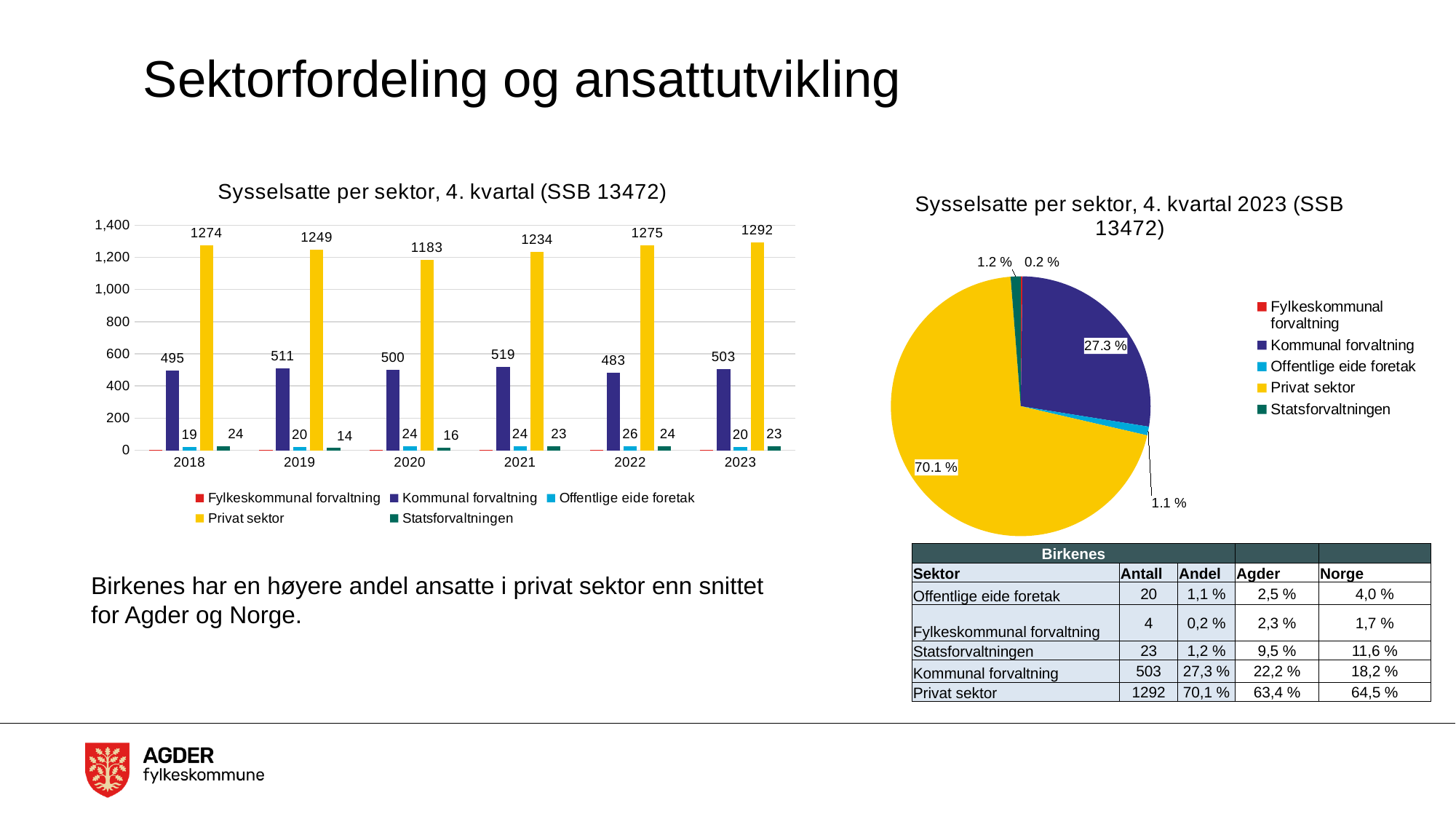
In the pie chart 'Sysselsatte per sektor, 4. kvartal 2023 (SSB 13472)', which sector has the smallest slice? Fylkeskommunal forvaltning In the bar chart 'Sysselsatte per sektor, 4. kvartal (SSB 13472)', which is larger: Statsforvaltningen in 2019 or Offentlige eide foretak in 2019? Offentlige eide foretak In the bar chart 'Sysselsatte per sektor, 4. kvartal (SSB 13472)', what is the difference between Privat sektor in 2023 and in 2022? 17 What kind of chart is the left chart 'Sysselsatte per sektor, 4. kvartal (SSB 13472)'? Bar chart In the bar chart 'Sysselsatte per sektor, 4. kvartal (SSB 13472)', in which year is Privat sektor highest? 2023 In the bar chart 'Sysselsatte per sektor, 4. kvartal (SSB 13472)', what is the value for Privat sektor in 2023? 1292 In the bar chart 'Sysselsatte per sektor, 4. kvartal (SSB 13472)', what is the value for Kommunal forvaltning in 2021? 519 In the pie chart 'Sysselsatte per sektor, 4. kvartal 2023 (SSB 13472)', what share does Kommunal forvaltning have? 27.3 % In the bar chart 'Sysselsatte per sektor, 4. kvartal (SSB 13472)', how many series does the legend list? 5 In the bar chart 'Sysselsatte per sektor, 4. kvartal (SSB 13472)', in which year is Privat sektor lowest? 2020 In the pie chart 'Sysselsatte per sektor, 4. kvartal 2023 (SSB 13472)', what share does Privat sektor have? 70.1 % In the bar chart 'Sysselsatte per sektor, 4. kvartal (SSB 13472)', how many years are shown on the x axis? 6